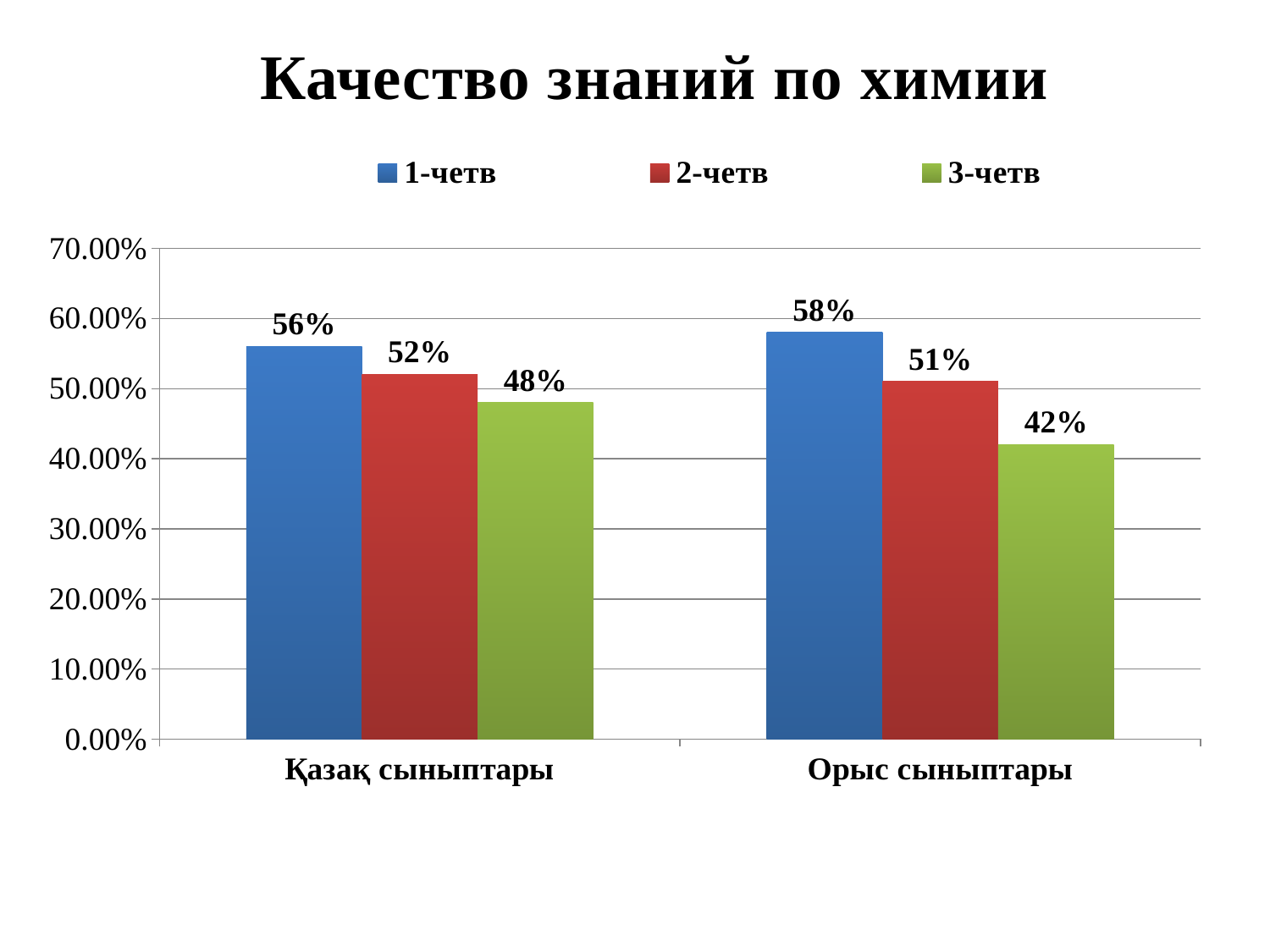
What is the value for 3-четв in the Орыс сыныптары category? 42% What is the difference between the 1-четв values for Орыс сыныптары and Қазақ сыныптары? 2% What kind of chart is shown on the slide? bar chart What is the value for 1-четв in the Қазақ сыныптары category? 56% How many categories are shown on the x axis? 2 What is the difference between the 1-четв and 3-четв values for Орыс сыныптары? 16% What is the title of the chart? Качество знаний по химии How many series does the legend list? 3 What is the value for 2-четв in the Орыс сыныптары category? 51% Which series has the lowest value in the Қазақ сыныптары category? 3-четв Which is larger: the 3-четв value for Қазақ сыныптары or the 3-четв value for Орыс сыныптары? Қазақ сыныптары Which series has the highest value in the Орыс сыныптары category? 1-четв